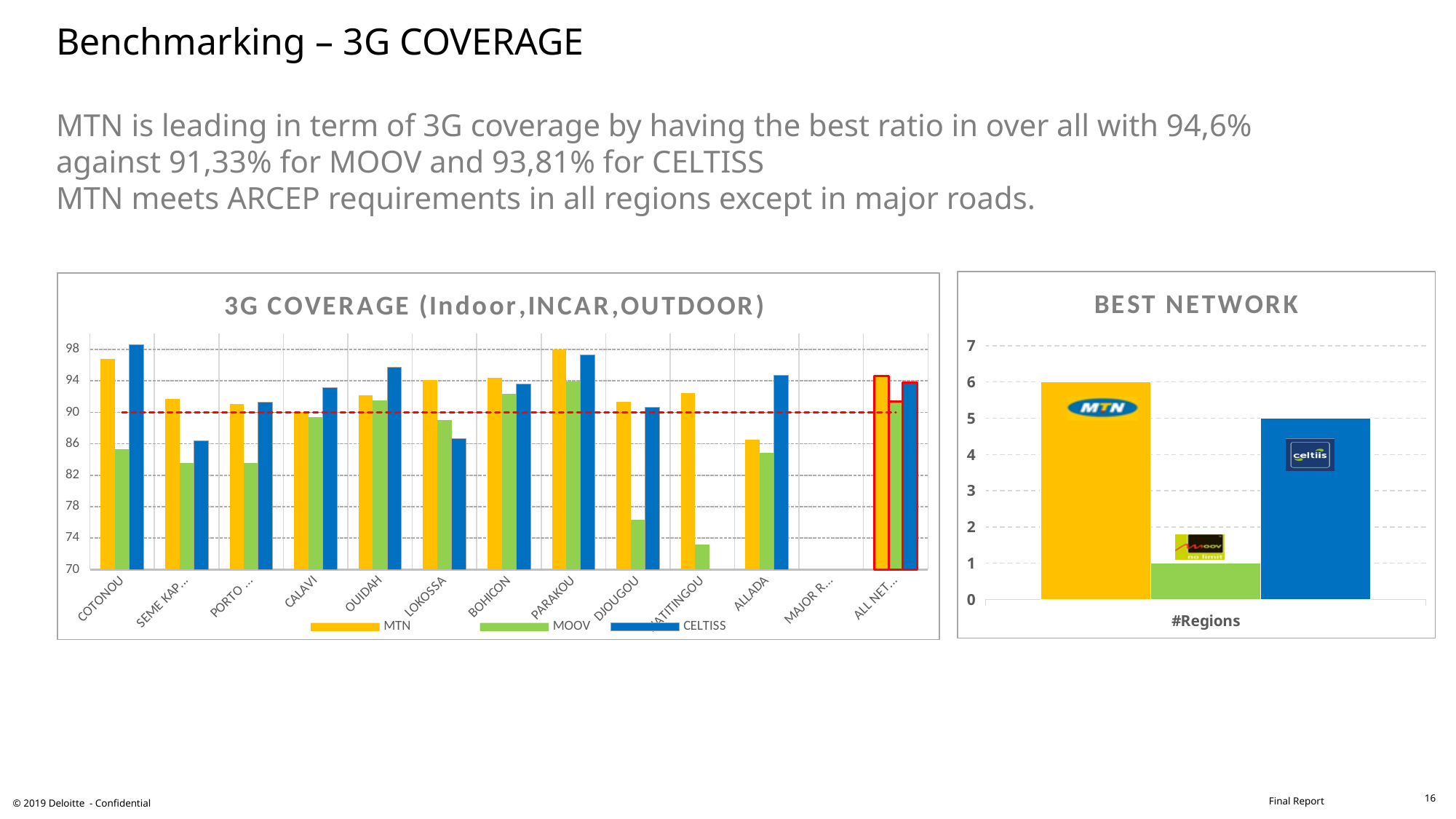
In the BEST NETWORK chart, what is the value for CELTISS? 5 What kind of chart is the 3G COVERAGE (Indoor,INCAR,OUTDOOR) chart? bar chart In the 3G COVERAGE (Indoor,INCAR,OUTDOOR) chart, is the MOOV value for DJOUGOU greater or less than 78? less In the 3G COVERAGE (Indoor,INCAR,OUTDOOR) chart, how many series does the legend list? 3 In the BEST NETWORK chart, how many bars are plotted? 3 In the BEST NETWORK chart, what is the value for MTN? 6 In the 3G COVERAGE (Indoor,INCAR,OUTDOOR) chart, which is larger for COTONOU, the MTN value or the MOOV value? MTN In the BEST NETWORK chart, what is the value for MOOV? 1 In the 3G COVERAGE (Indoor,INCAR,OUTDOOR) chart, is the MTN value for PARAKOU greater or less than 94? greater In the BEST NETWORK chart, what is the difference between the MTN and CELTISS values? 1 In the BEST NETWORK chart, which network has the highest number of regions? MTN